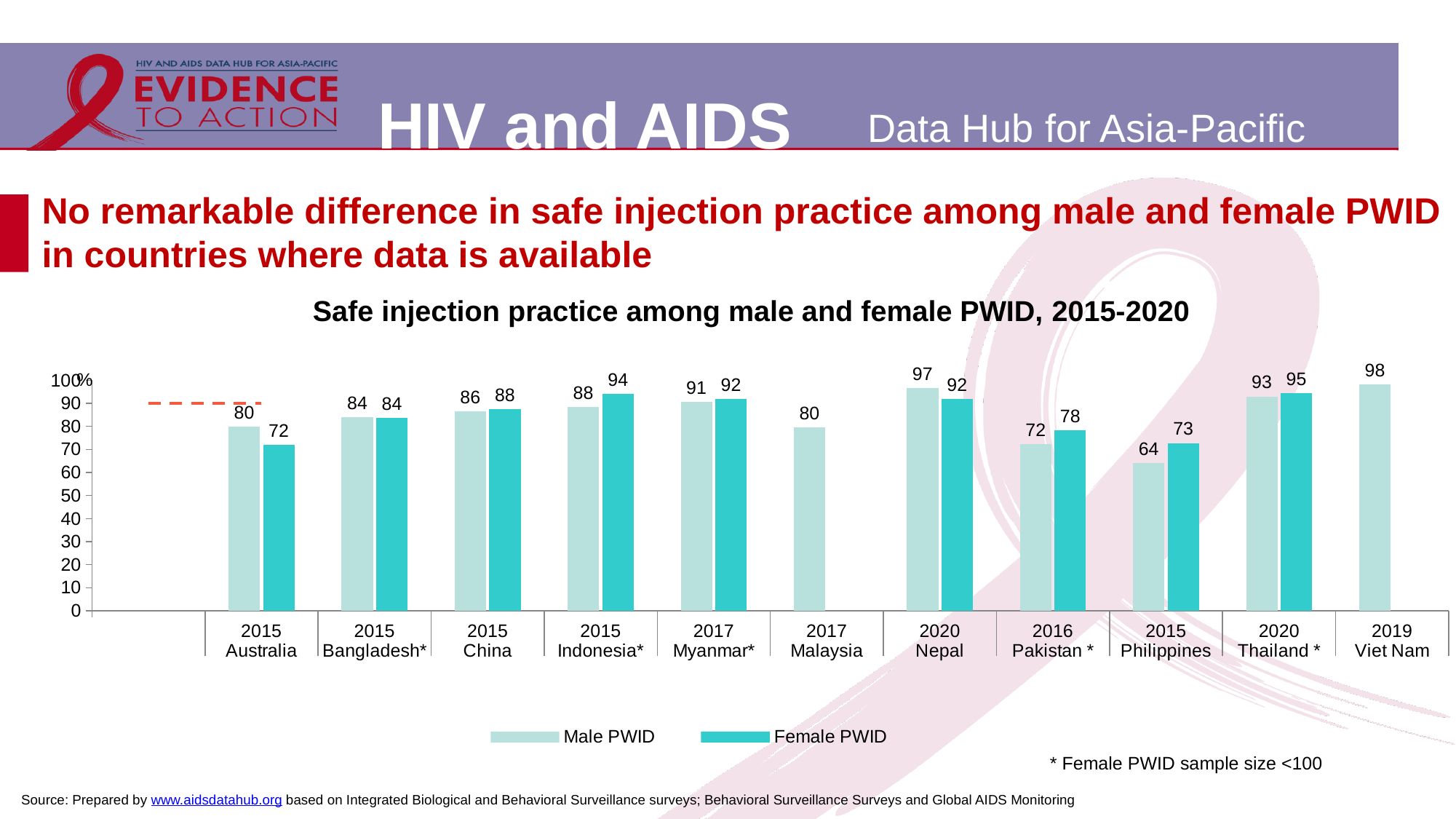
What is the Male PWID value for Australia (2015)? 80 What is the title of the chart? Safe injection practice among male and female PWID, 2015-2020 Which country has the lowest Male PWID value? Philippines How many series does the legend list? 2 What is the Female PWID value for Pakistan (2016)? 78 What is the Female PWID value for the Philippines (2015)? 73 How many country categories are shown on the x axis? 11 Which country has the highest Male PWID value? Viet Nam Which country has the lowest Female PWID value? Australia What kind of chart is shown on the slide? Bar chart For Nepal (2020), which is larger: the Male PWID value or the Female PWID value? Male PWID What is the difference between the Female PWID and Male PWID values for Indonesia (2015)? 6